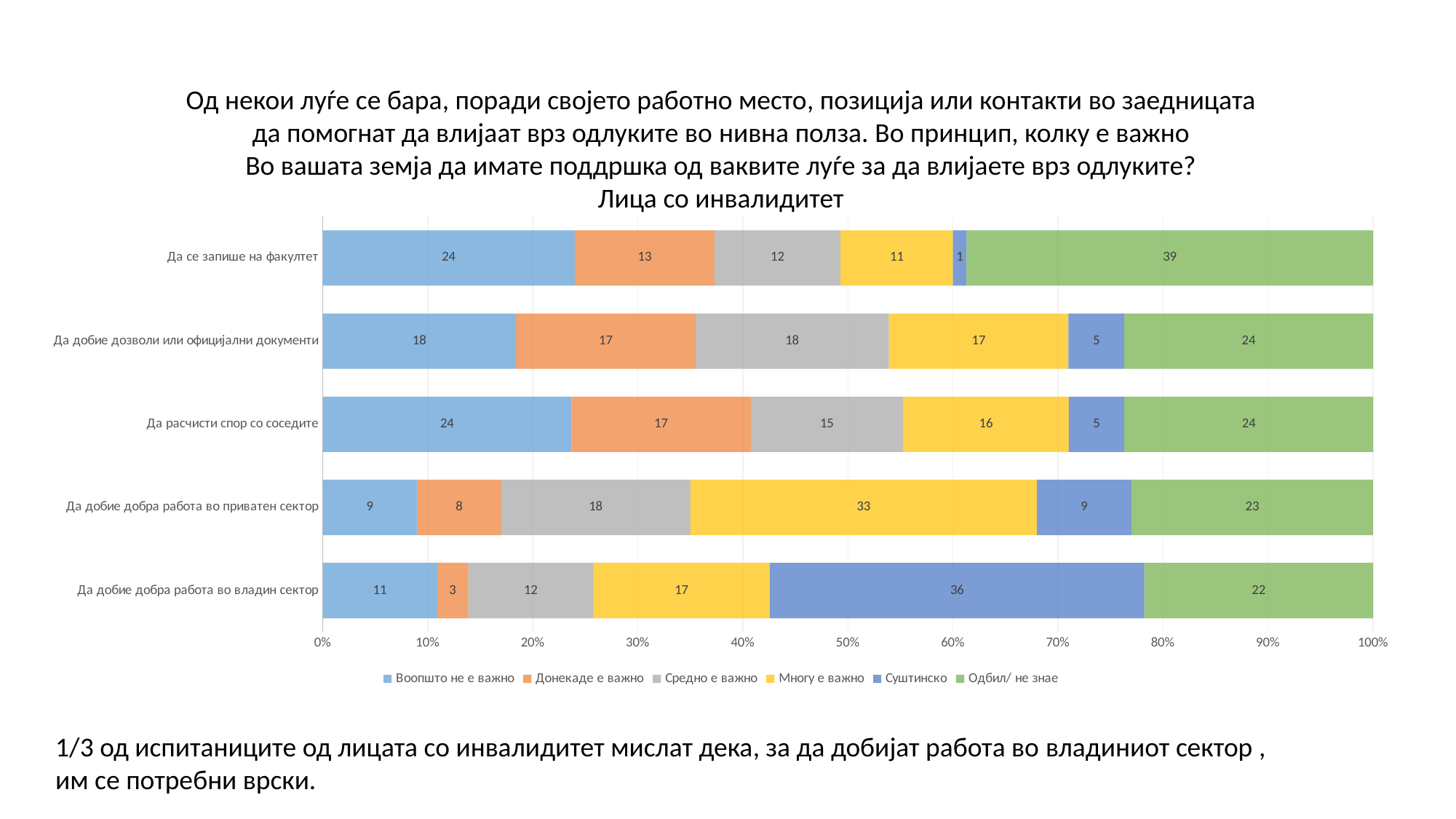
Which is larger: the "Средно е важно" value for "Да добие дозволи или официјални документи" or for "Да расчисти спор со соседите"? Да добие дозволи или официјални документи What type of chart is shown on the slide? Stacked bar chart What is the value of "Одбил/ не знае" for "Да се запише на факултет"? 39 What is the value of "Суштинско" for "Да добие добра работа во владин сектор"? 36 Which legend entry is shown in green? Одбил/ не знае How many series does the legend list? 6 How many categories are shown on the vertical axis of the chart? 5 What is the difference between the "Воопшто не е важно" values for "Да се запише на факултет" and "Да добие добра работа во приватен сектор"? 15 Which category has the lowest value for "Донекаде е важно"? Да добие добра работа во владин сектор What is the total of the printed values in the bar for "Да се запише на факултет"? 100 Which category has the highest value for "Суштинско"? Да добие добра работа во владин сектор What is the value of "Многу е важно" for "Да добие добра работа во приватен сектор"? 33